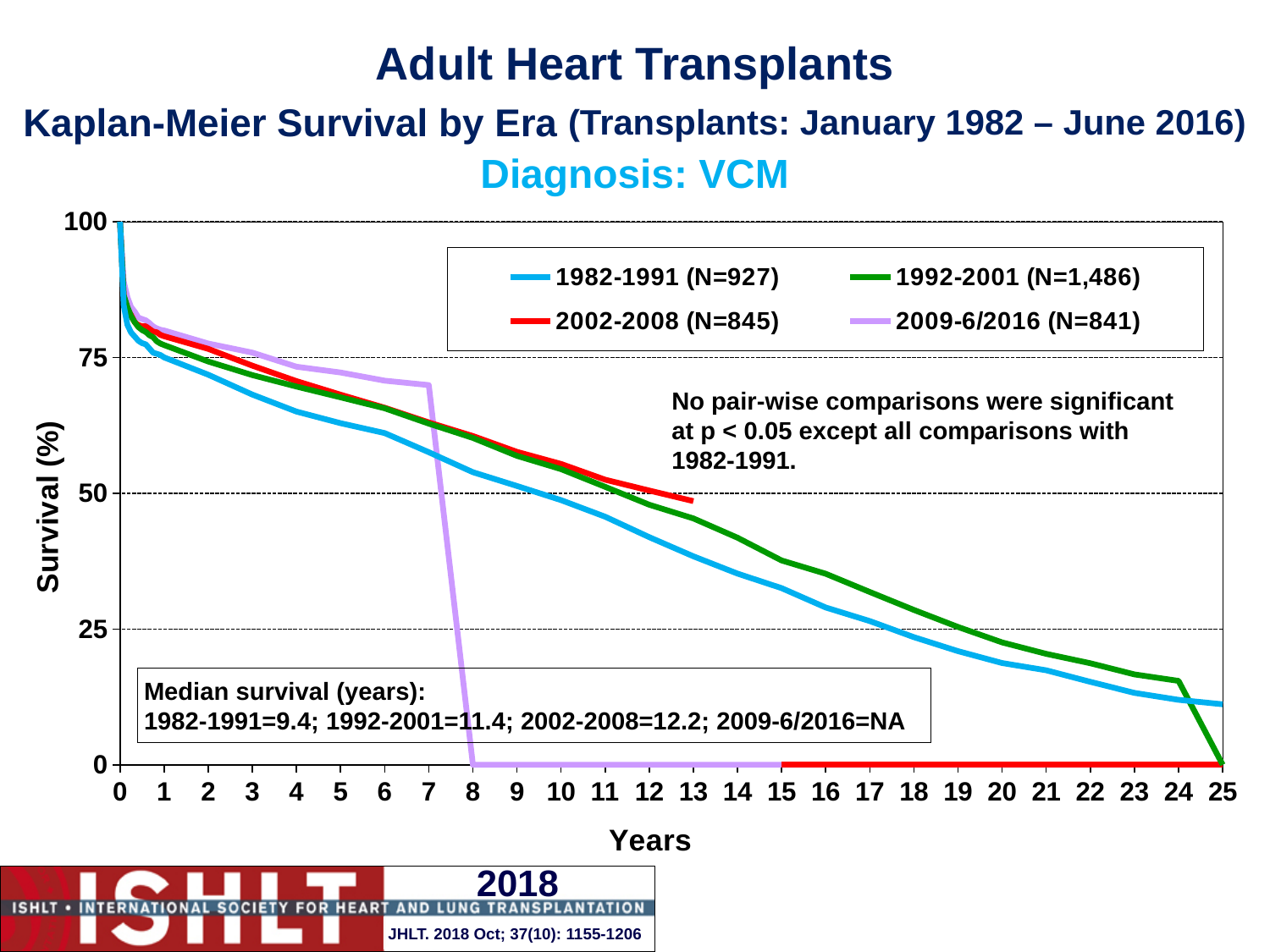
What is the median survival in years for the 1982-1991 era? 9.4 Which era has the largest N in the legend? 1992-2001 (N=1,486) What is the median survival in years for the 2002-2008 era? 12.2 Which era has the lowest median survival among those with a value given? 1982-1991 What type of chart is shown on the slide? Line chart Which era has the highest median survival shown in the text box? 2002-2008 What is the difference in median survival (years) between the 2002-2008 era and the 1982-1991 era? 2.8 Is the survival for the 1982-1991 era at year 20 greater or less than 25? less How many eras (series) does the legend list? 4 Is the survival for the 2009-6/2016 era at year 7 greater or less than 50? greater Do the survival curves rise or fall as years increase? Fall At year 3, which era has higher survival: 1982-1991 or 2009-6/2016? 2009-6/2016